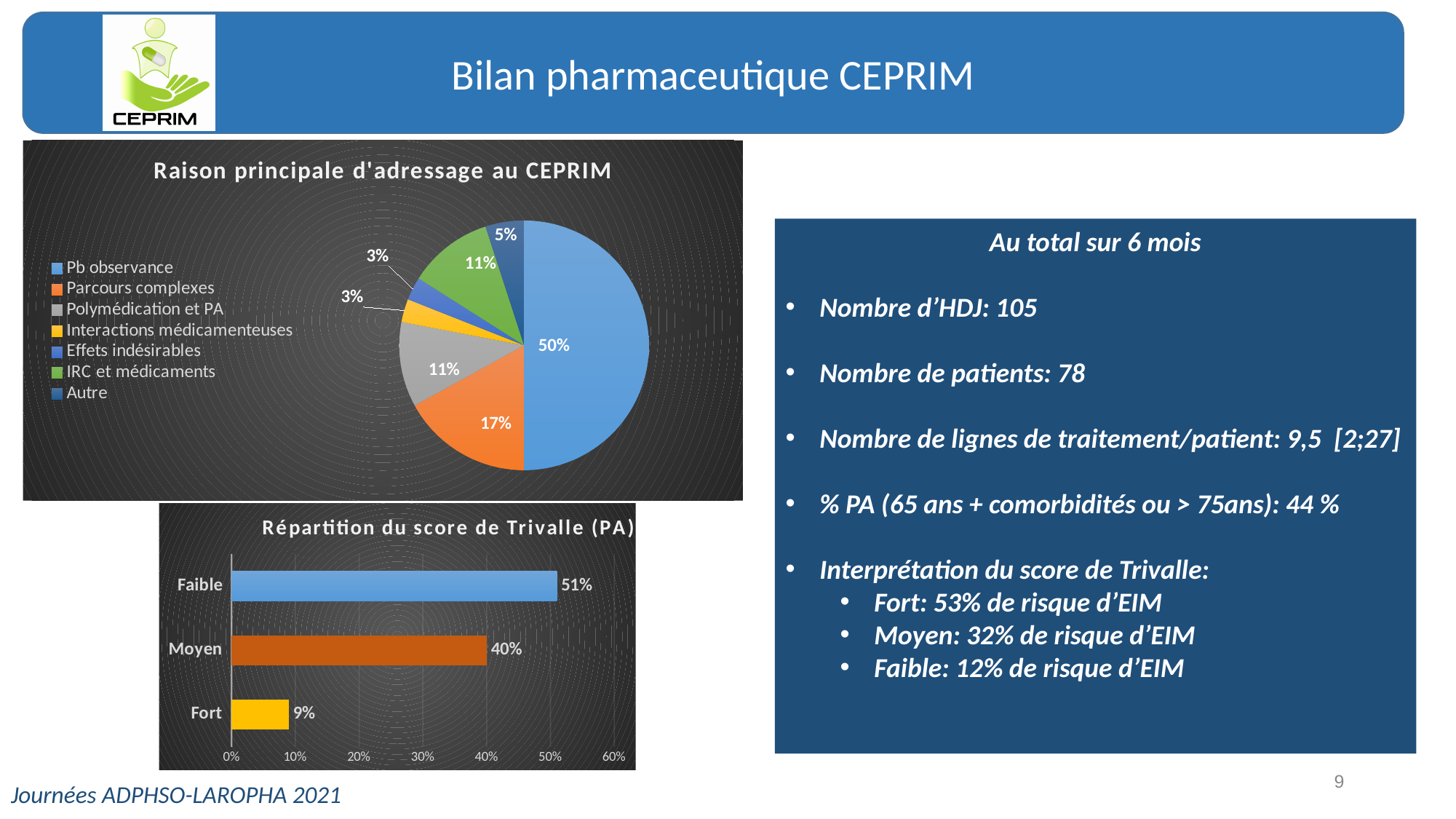
In the chart 'Répartition du score de Trivalle (PA)', what is the value for 'Fort'? 9% What kind of chart is 'Raison principale d'adressage au CEPRIM'? Pie chart In the chart 'Raison principale d'adressage au CEPRIM', what share does 'Pb observance' have? 50% In the chart 'Raison principale d'adressage au CEPRIM', what share does 'Autre' have? 5% In the chart 'Raison principale d'adressage au CEPRIM', which category has the largest slice? Pb observance In the chart 'Répartition du score de Trivalle (PA)', which category has the lowest value? Fort In the chart 'Répartition du score de Trivalle (PA)', what is the value for 'Moyen'? 40% In the chart 'Répartition du score de Trivalle (PA)', what is the difference between 'Faible' and 'Moyen'? 11% In the chart 'Raison principale d'adressage au CEPRIM', what share does 'Parcours complexes' have? 17% In the chart 'Raison principale d'adressage au CEPRIM', what is the difference between the shares of 'Pb observance' and 'Parcours complexes'? 33% In the chart 'Raison principale d'adressage au CEPRIM', how many categories does the legend list? 7 What kind of chart is 'Répartition du score de Trivalle (PA)'? Bar chart